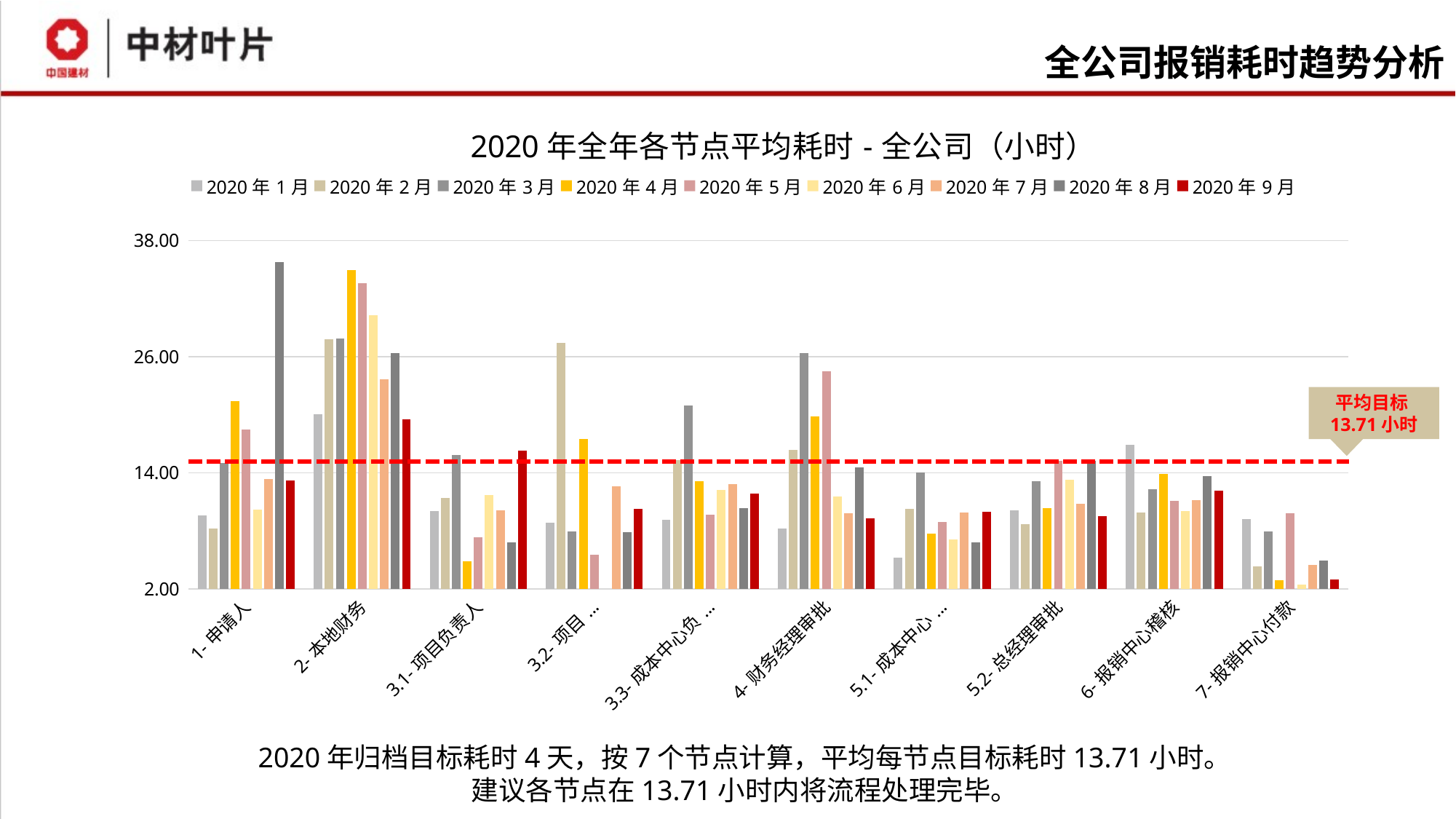
Which month has the lowest value at 3.1-项目负责人? 2020年4月 Is the value for 2020年9月 at 7-报销中心付款 greater or less than 14.00? less What kind of chart is shown on the slide? Bar chart Which month has the highest value at 1-申请人? 2020年8月 How many series does the legend list? 9 What value does the red dashed target line (平均目标) represent? 13.71 小时 What is the title of the chart? 2020年全年各节点平均耗时 - 全公司（小时） Is the value for 2020年4月 at 2-本地财务 greater or less than 26.00? greater Which is larger: the 2020年8月 value at 1-申请人 or the 2020年8月 value at 2-本地财务? 1-申请人 How many categories (nodes) are shown on the x axis? 10 Is the value for 2020年8月 at 1-申请人 greater or less than 26.00? greater